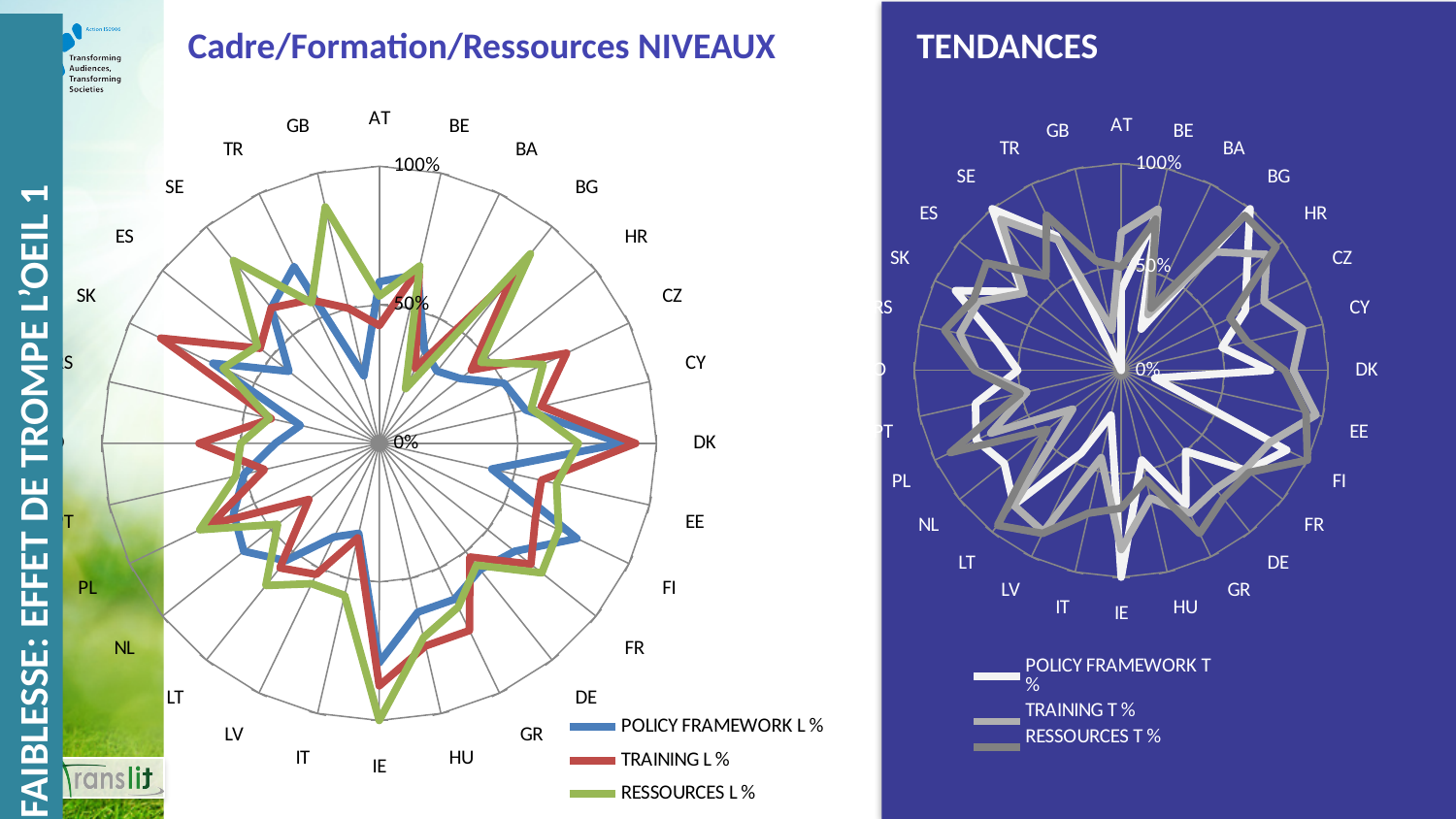
In the "Cadre/Formation/Ressources NIVEAUX" chart, is the RESSOURCES L % value for IE greater or less than 50%? greater What are the three legend entries of the "TENDANCES" chart? POLICY FRAMEWORK T %, TRAINING T %, RESSOURCES T % In the "Cadre/Formation/Ressources NIVEAUX" chart, which is larger at IE: RESSOURCES L % or POLICY FRAMEWORK L %? RESSOURCES L % In the "Cadre/Formation/Ressources NIVEAUX" chart, which is larger at DK: TRAINING L % or POLICY FRAMEWORK L %? TRAINING L % What kind of chart is the chart titled "Cadre/Formation/Ressources NIVEAUX"? Radar chart How many series does the legend of the "TENDANCES" chart list? 3 What kind of chart is the chart titled "TENDANCES"? Radar chart In the "Cadre/Formation/Ressources NIVEAUX" chart, is the TRAINING L % value for DK greater or less than 50%? greater In the "Cadre/Formation/Ressources NIVEAUX" chart, which colour represents TRAINING L %? Red How many series does the legend of the "Cadre/Formation/Ressources NIVEAUX" chart list? 3 In the "TENDANCES" chart, is the POLICY FRAMEWORK T % value for DK greater or less than 50%? greater